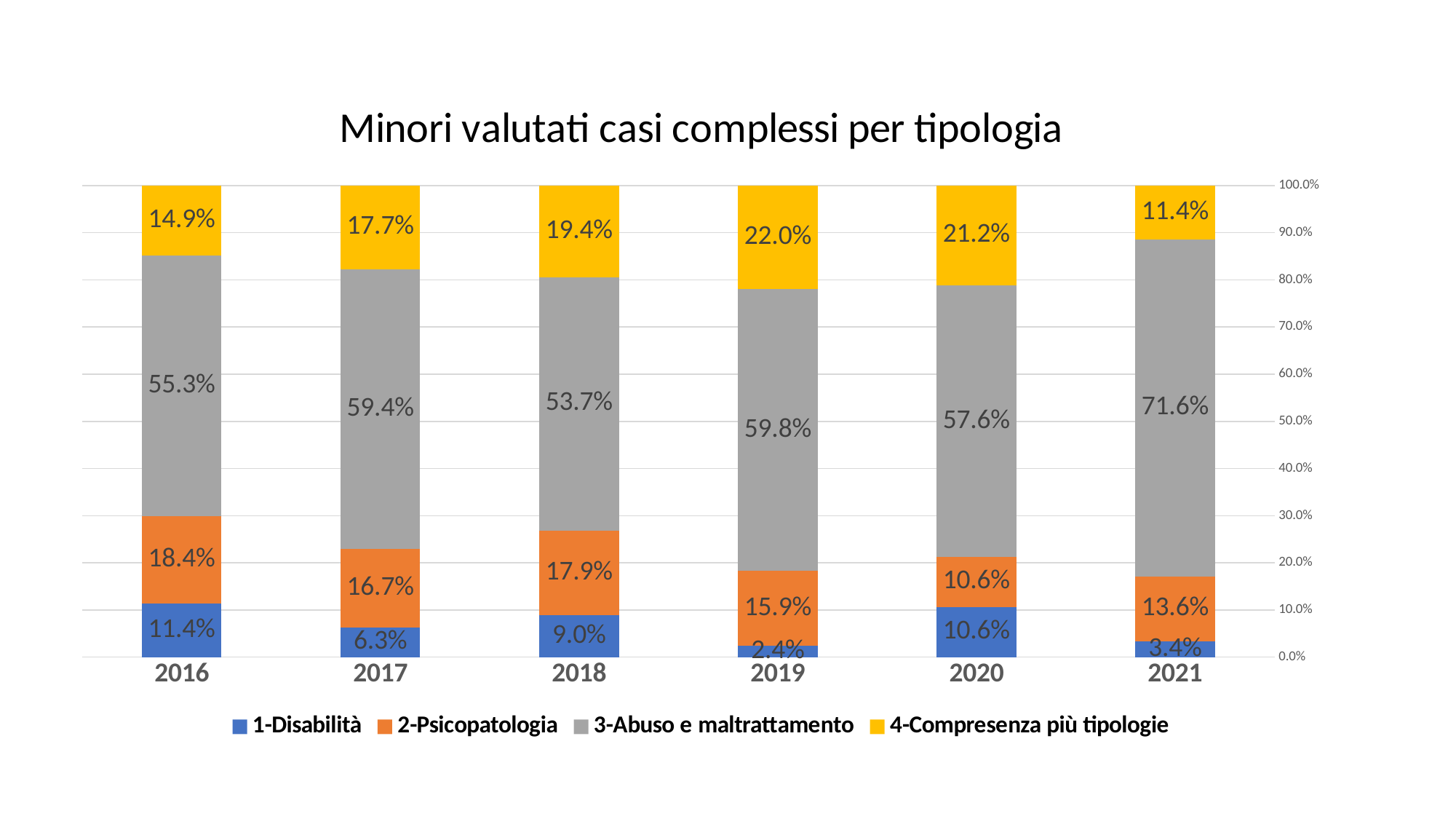
What is the value for 3-Abuso e maltrattamento in 2021? 71.6% What kind of chart is shown on the slide? Stacked bar chart What is the value for 1-Disabilità in 2019? 2.4% How many years are shown on the x axis? 6 Which is larger, the 3-Abuso e maltrattamento value in 2017 or in 2018? 2017 How many series does the legend list? 4 In which year is the value for 1-Disabilità lowest? 2019 What is the value for 2-Psicopatologia in 2017? 16.7% In which year is the value for 4-Compresenza più tipologie highest? 2019 What is the difference between the 2-Psicopatologia values for 2016 and 2020? 7.8% What is the value for 4-Compresenza più tipologie in 2018? 19.4% What is the title of the chart? Minori valutati casi complessi per tipologia